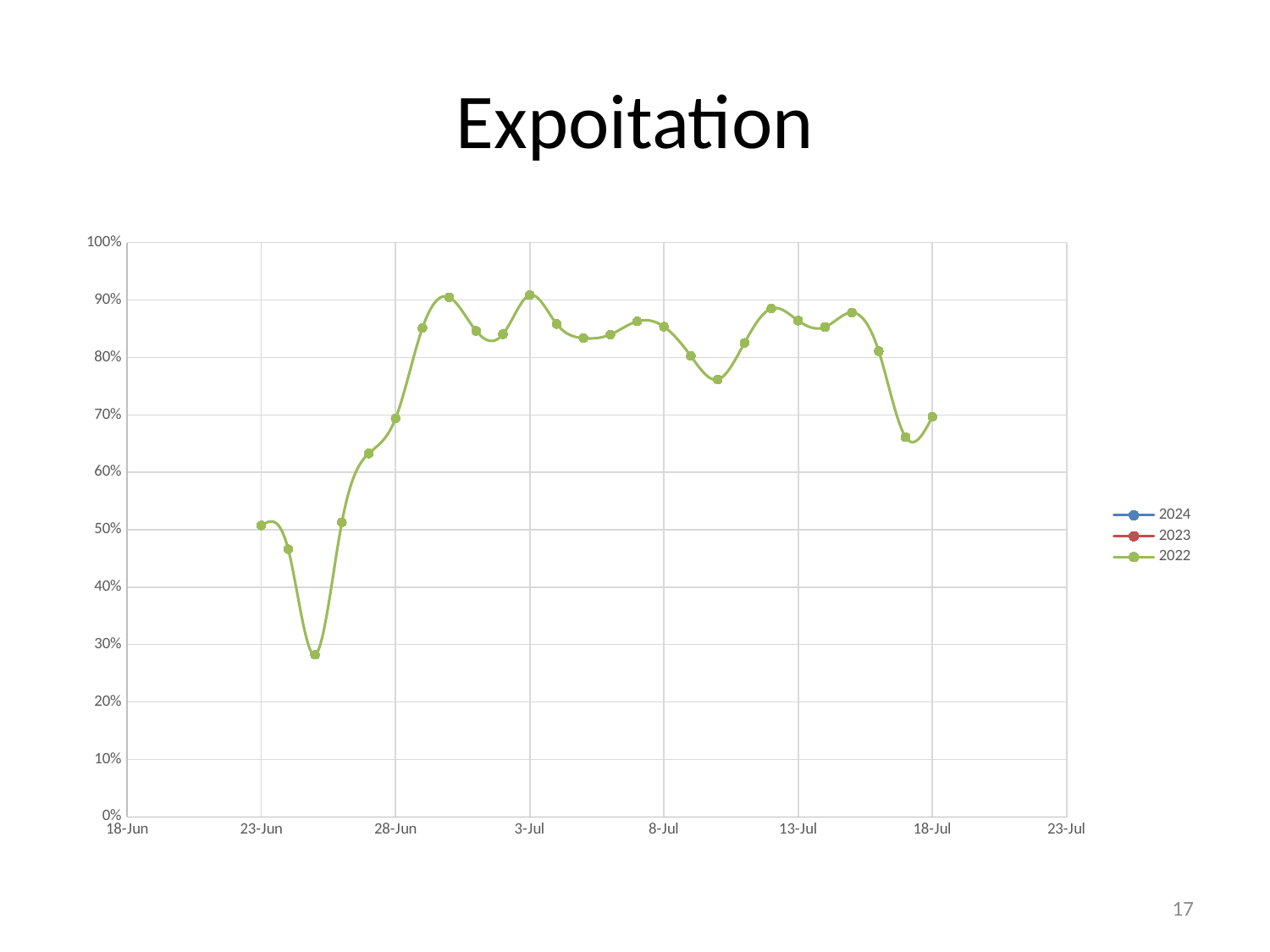
Is the lowest value of the 2022 series greater or less than 40%? less What is the title of the chart? Expoitation Is the value of the 2022 series on 18-Jul greater or less than 80%? less Is the value of the 2022 series on 23-Jun greater or less than 60%? less How many series does the legend list? 3 Does the 2022 series rise or fall between 13-Jul and 18-Jul? fall Which is larger for the 2022 series: the value on 23-Jun or the value on 28-Jun? 28-Jun What kind of chart is shown on the slide? line chart Which is larger for the 2022 series: the value on 3-Jul or the value on 18-Jul? 3-Jul Which series in the legend is drawn in green? 2022